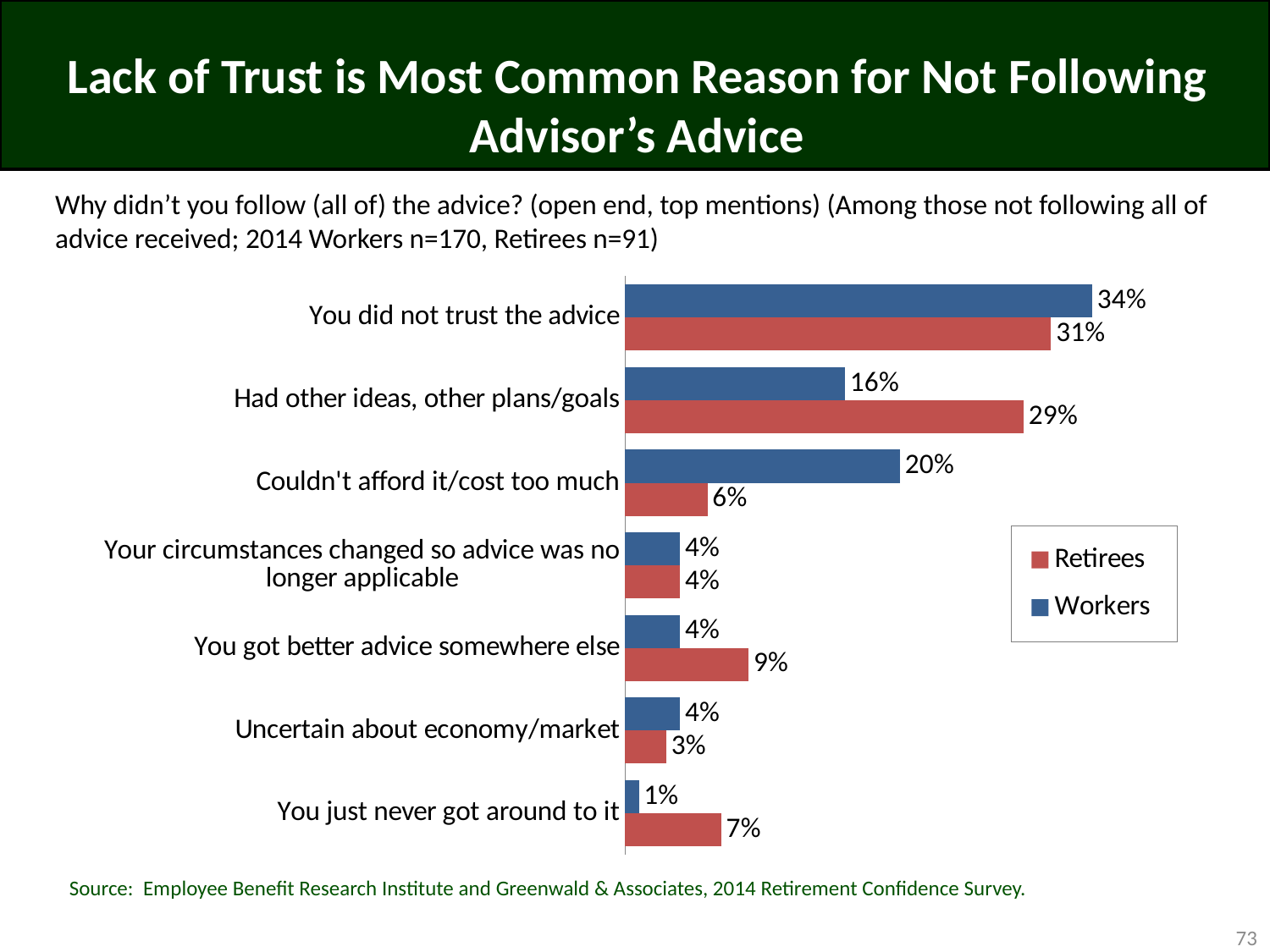
What is the difference between the Workers and Retirees values for 'Couldn't afford it/cost too much'? 14 percentage points Which reason has the lowest value for Workers? You just never got around to it What percentage of Workers said they did not trust the advice? 34% What kind of chart is shown on the slide? Bar chart How many reasons (categories) are shown on the chart? 7 How many series does the legend list? 2 Which reason has the highest value for Workers? You did not trust the advice For 'Had other ideas, other plans/goals', which group has the larger value, Workers or Retirees? Retirees What percentage of Retirees said they had other ideas, other plans/goals? 29% What percentage of Workers said they just never got around to it? 1% What percentage of Retirees said they couldn't afford it/cost too much? 6% Which colour represents Retirees in the chart? Red